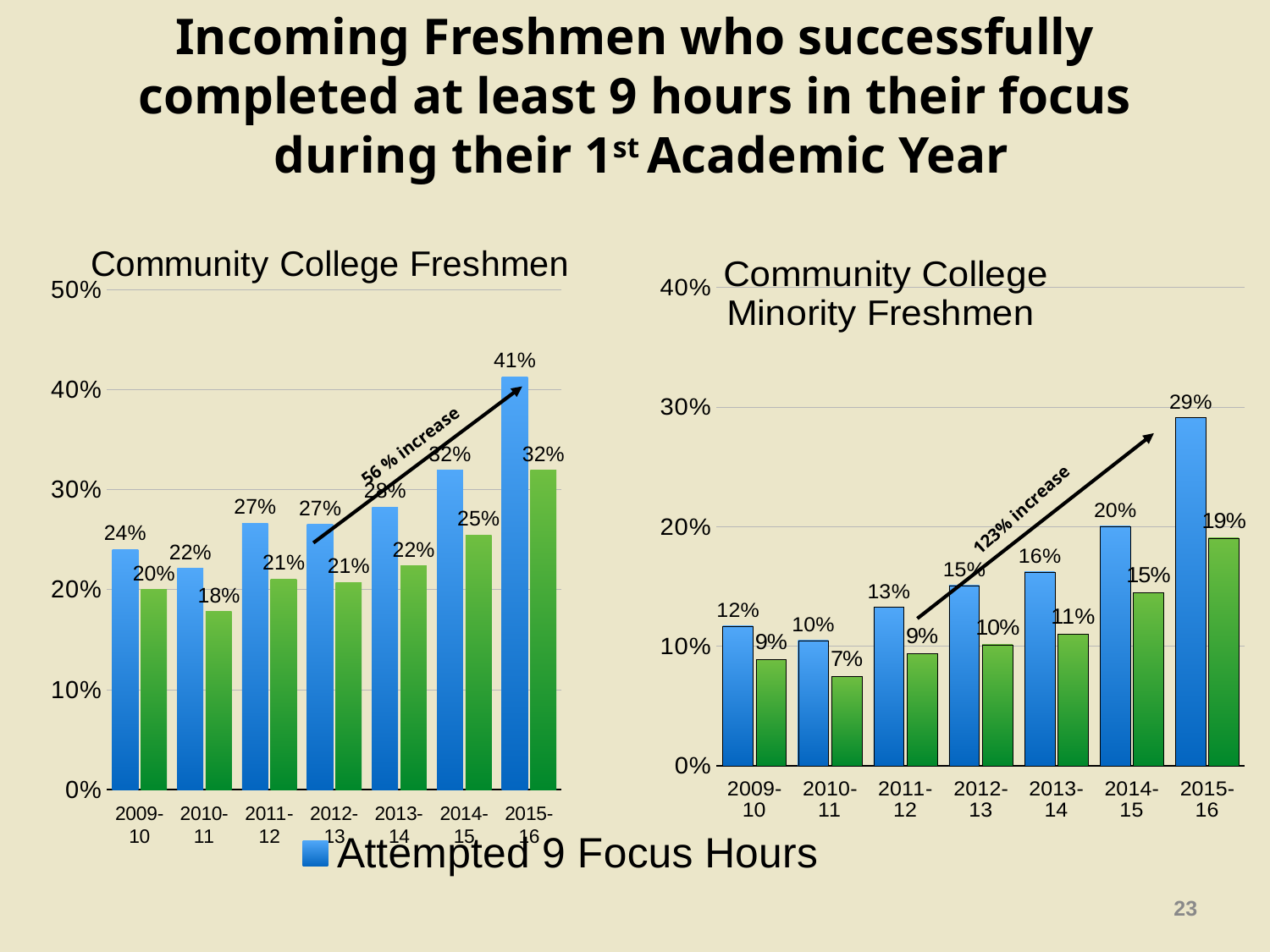
In the Community College Freshmen chart, which year has the highest blue bar? 2015-16 In the Community College Freshmen chart, what is the difference between the blue and green bars for 2015-16? 9 percentage points In the Community College Minority Freshmen chart, which year has the lowest green bar? 2010-11 In the Community College Minority Freshmen chart, what is the value of the blue bar for 2015-16? 29% In the Community College Minority Freshmen chart, what is the value of the green bar for 2010-11? 7% In the Community College Minority Freshmen chart, what is the difference between the blue bars for 2015-16 and 2014-15? 9 percentage points In the Community College Minority Freshmen chart, which is larger: the green bar for 2014-15 or the blue bar for 2009-10? The green bar for 2014-15 What percentage increase is annotated on the Community College Minority Freshmen chart? 123% increase In the Community College Freshmen chart, which year has the lowest green bar? 2010-11 How many academic years are shown on the x axis of the Community College Freshmen chart? 7 In the Community College Freshmen chart, what is the value of the green bar for 2010-11? 18% In the Community College Freshmen chart, what is the value of the blue bar for 2015-16? 41%